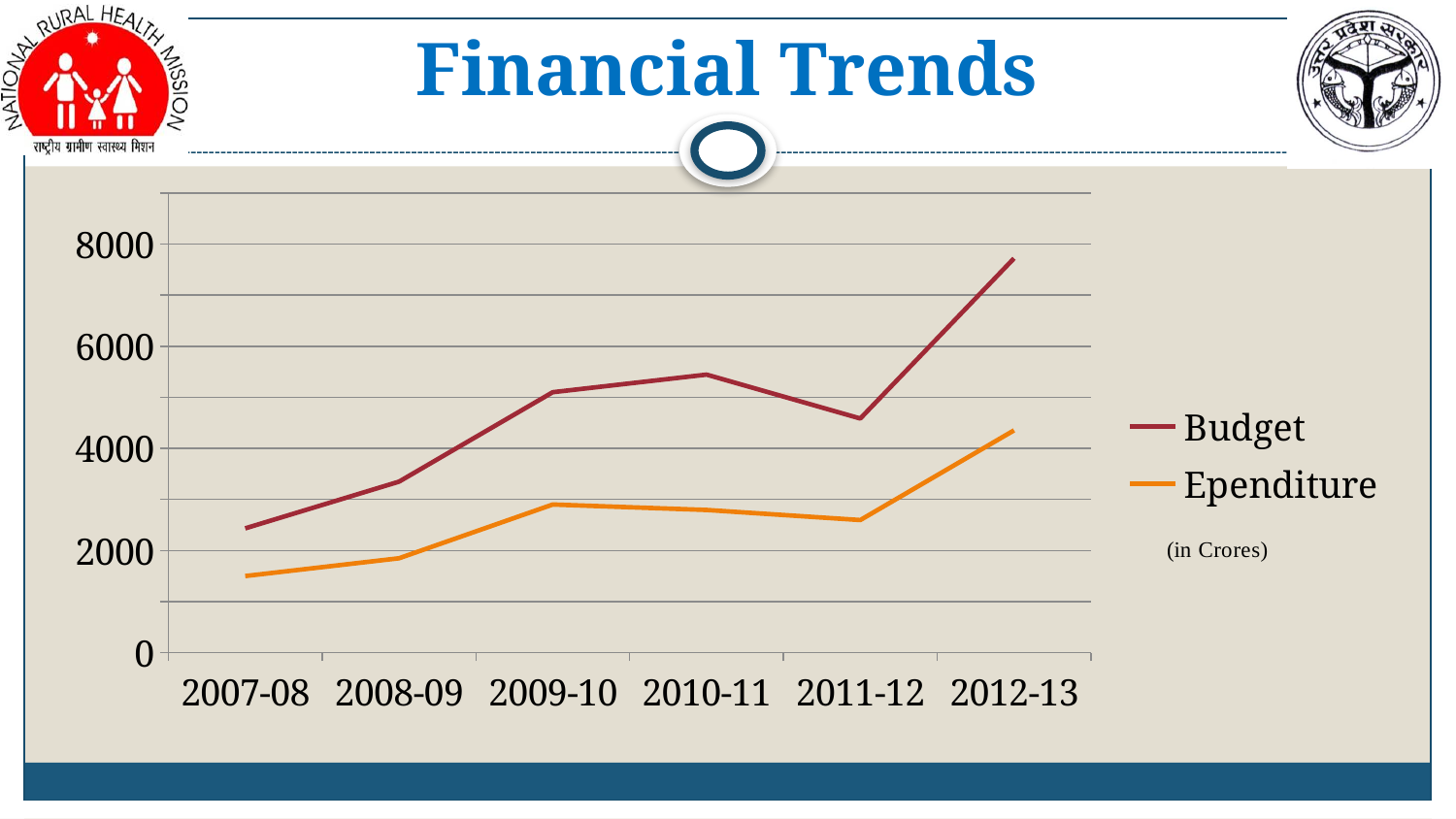
Which is larger for Budget, the value for 2010-11 or the value for 2011-12? 2010-11 Is the Budget value for 2012-13 greater or less than 6000? greater In which year is the Ependiture value lowest? 2007-08 How many series does the legend list? 2 In which year is the Budget value highest? 2012-13 What unit is stated below the legend for the values in the chart? in Crores Is the Ependiture value for 2007-08 greater or less than 2000? less What kind of chart is shown on the slide? line chart Does the Budget line rise or fall from 2010-11 to 2011-12? fall Is the Budget value for 2009-10 greater or less than 4000? greater Which is larger in 2010-11, the Budget value or the Ependiture value? Budget How many years are plotted along the x axis? 6